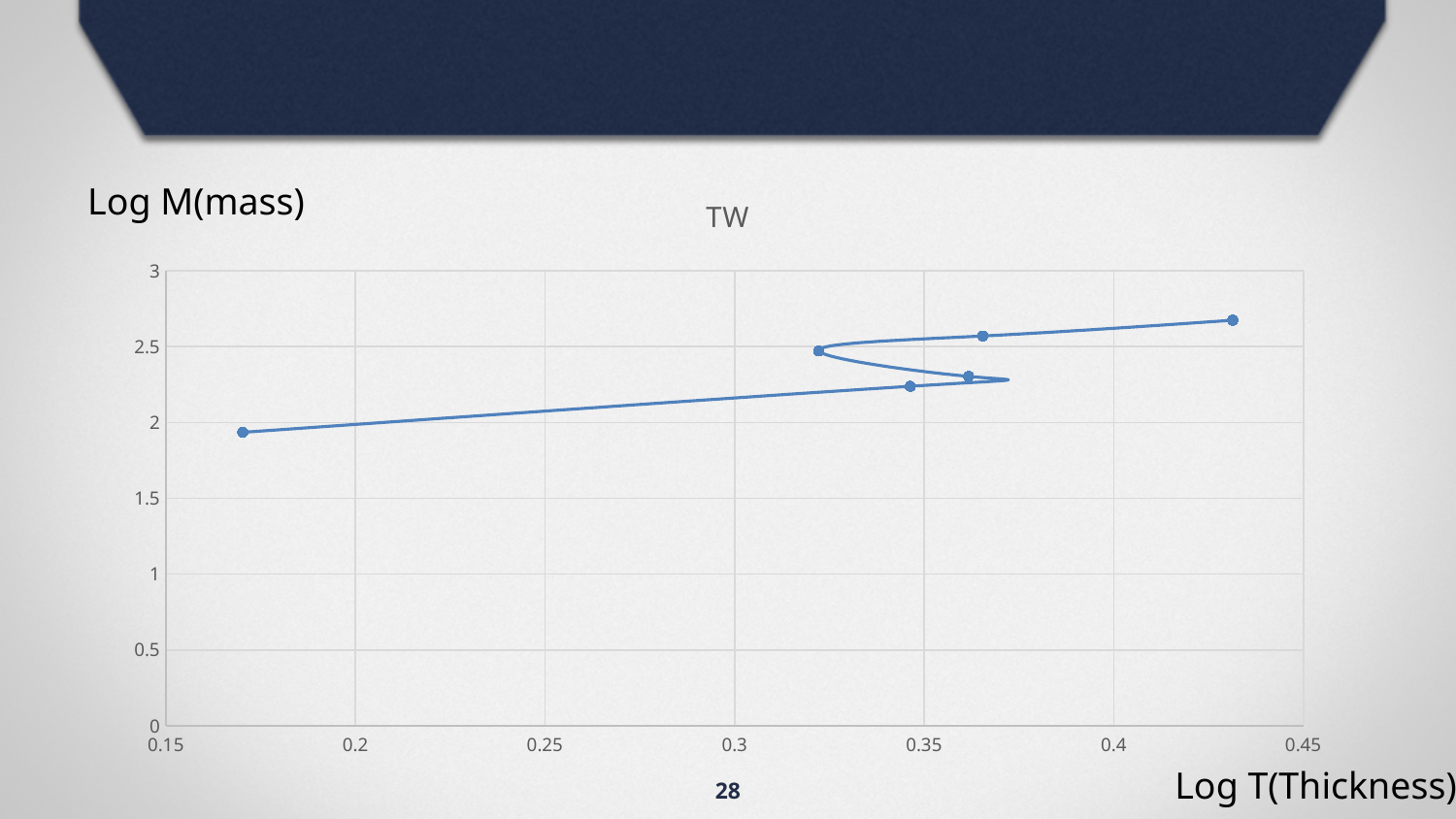
What label is given to the vertical axis of the chart? Log M(mass) Are all plotted points above or below the Log M value of 1? above Is the Log M value of the leftmost data point (near Log T = 0.17) greater or less than 2.5? less How many data points are plotted on the chart? 6 What is the highest value shown on the vertical axis? 3 Which data point has the highest Log M value: the leftmost point or the rightmost point? the rightmost point Is the Log M value of the leftmost data point greater or less than 1.5? greater Overall, does Log M rise or fall as Log T increases from 0.17 to 0.43? rise What is the title of the chart? TW Does the data point with the lowest Log M value lie at the left end or the right end of the x axis? the left end What kind of chart is shown on the slide? Scatter chart with a smoothed line